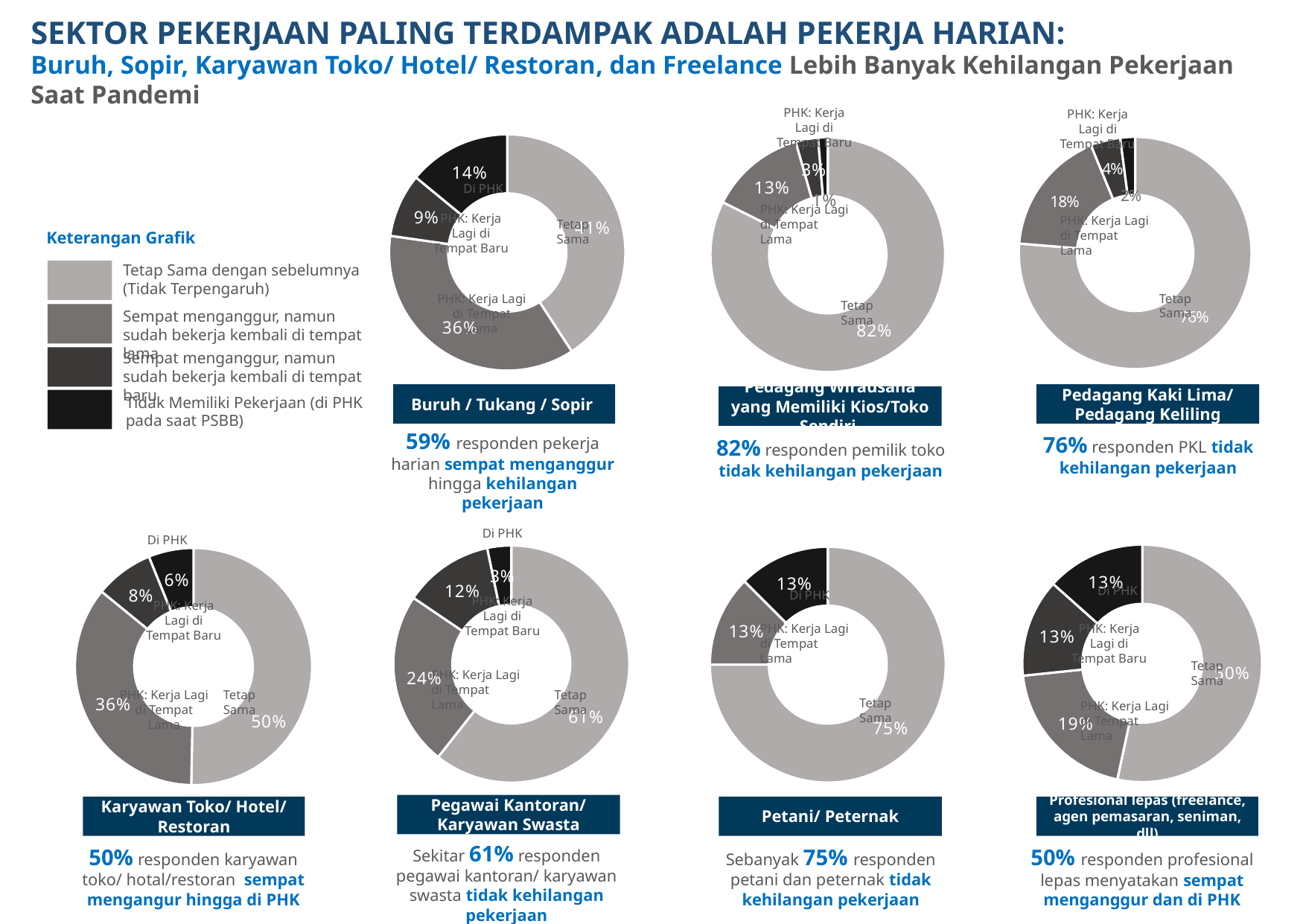
What kind of chart is used for each job sector on this slide? Donut (pie) chart In the Pegawai Kantoran/ Karyawan Swasta chart, what is the difference between the Tetap Sama share and the PHK: Kerja Lagi di Tempat Lama share? 37% In the Pedagang Kaki Lima/ Pedagang Keliling chart, what percentage is shown for PHK: Kerja Lagi di Tempat Lama? 18% In the Profesional lepas chart, which is larger: PHK: Kerja Lagi di Tempat Lama or Di PHK? PHK: Kerja Lagi di Tempat Lama In the Buruh / Tukang / Sopir chart, what percentage is shown for PHK: Kerja Lagi di Tempat Lama? 36% In the Buruh / Tukang / Sopir chart, what percentage of respondents are labelled Di PHK? 14% In the Karyawan Toko/ Hotel/ Restoran chart, which segment is the smallest? Di PHK In the Petani/ Peternak chart, what percentage is shown for Tetap Sama? 75% How many categories does the legend (Keterangan Grafik) list? 4 How many donut charts are shown on the slide? 7 In the Pedagang Wirausaha yang Memiliki Kios/Toko Sendiri chart, what percentage is shown for Tetap Sama? 82% In the Karyawan Toko/ Hotel/ Restoran chart, which segment is the largest? Tetap Sama